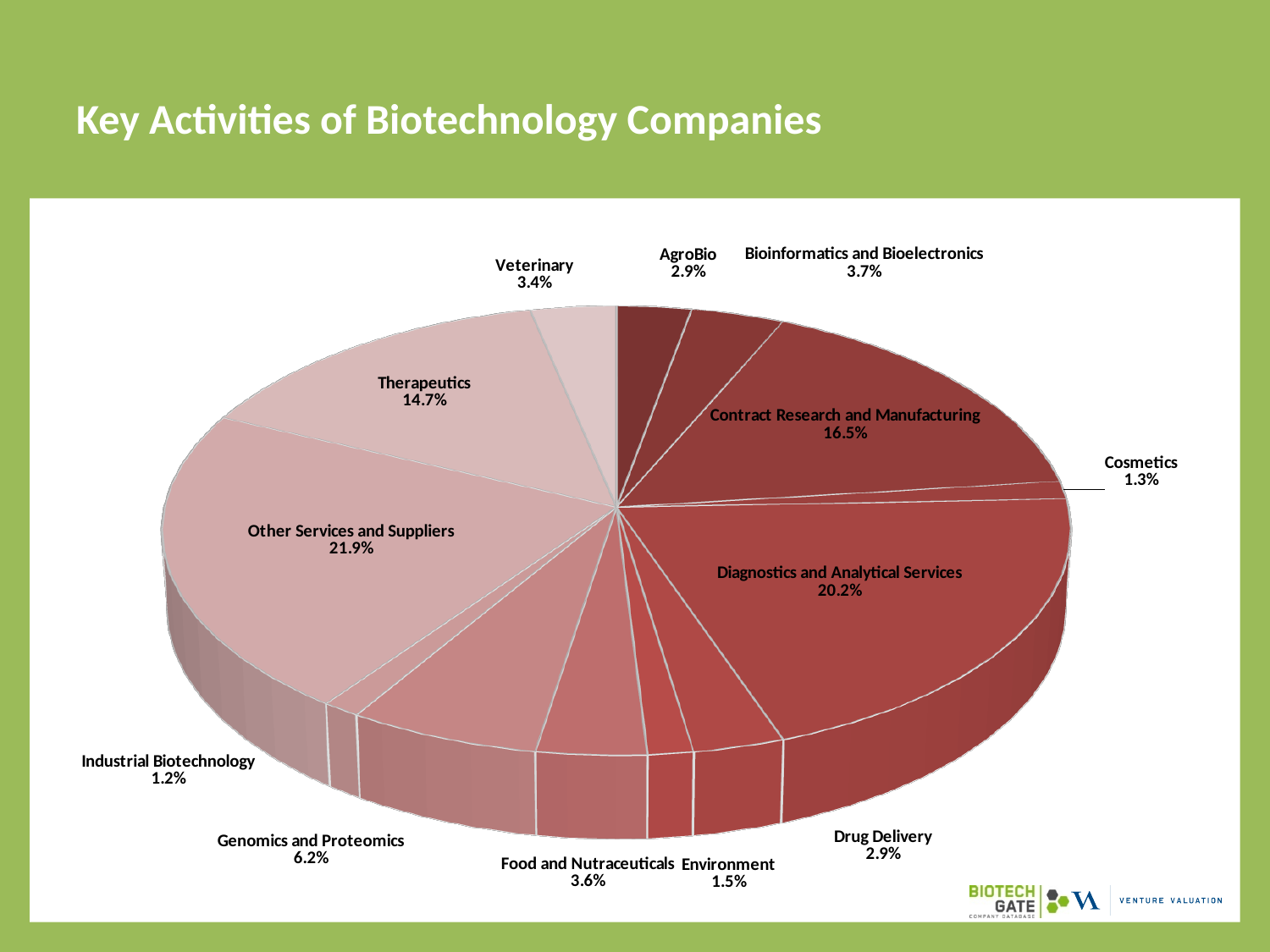
What is the title of the chart? Key Activities of Biotechnology Companies Which two categories both have a share of 2.9%? AgroBio and Drug Delivery Which is larger, the share for Veterinary or the share for Bioinformatics and Bioelectronics? Bioinformatics and Bioelectronics Which category has the largest share of the pie? Other Services and Suppliers How many categories are shown in the pie chart? 13 What percentage is shown for Therapeutics? 14.7% What kind of chart is shown on the slide? Pie chart What is the difference in percentage points between Other Services and Suppliers and Contract Research and Manufacturing? 5.4 What share of the pie is Diagnostics and Analytical Services? 20.2% What percentage is shown for Genomics and Proteomics? 6.2% What percentage is shown for Cosmetics? 1.3% Which category has the smallest share of the pie? Industrial Biotechnology